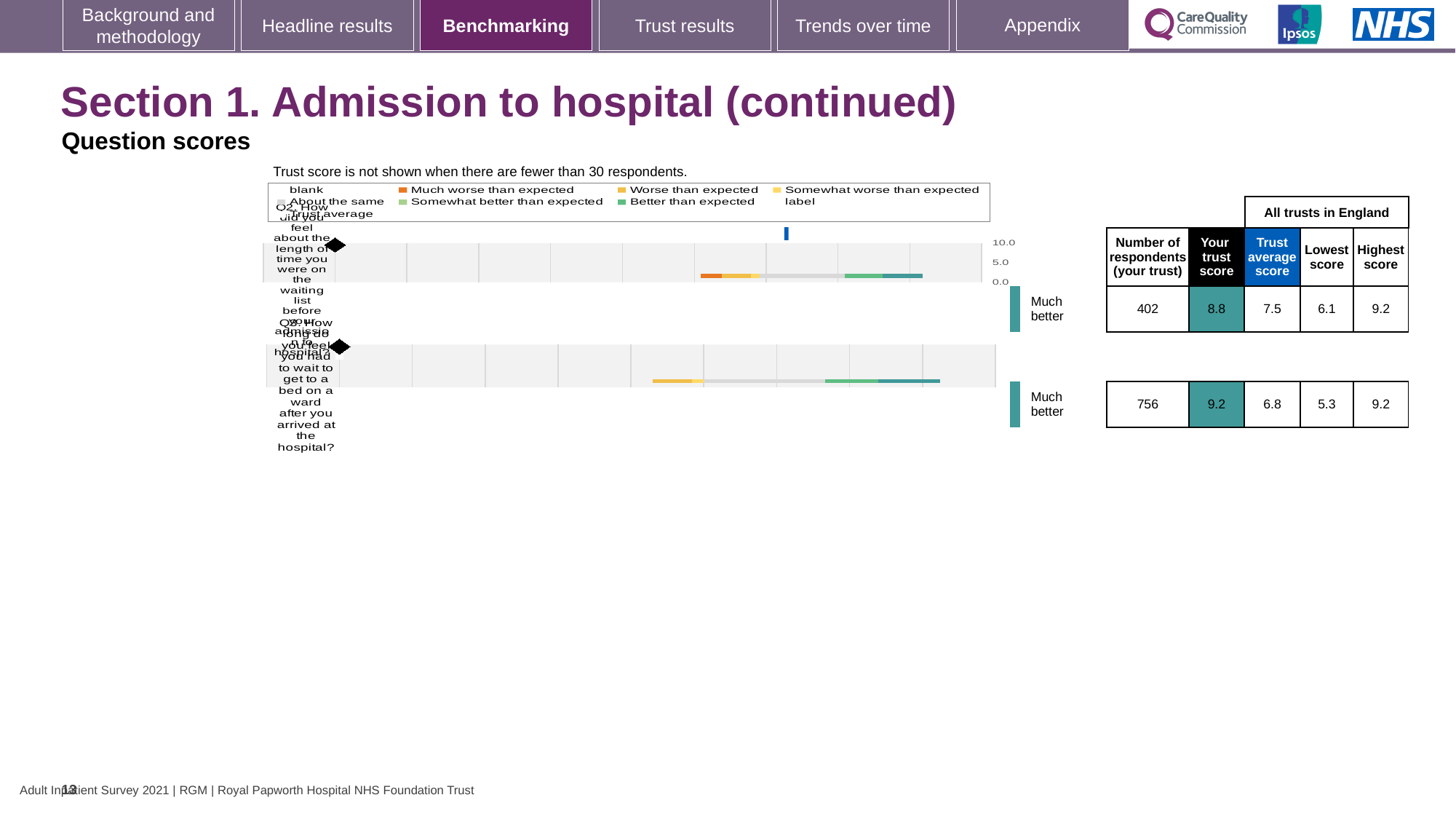
By how much does the trust's score for Q2 exceed the trust average score for Q2? 1.3 What is the highest score across all trusts in England for Q2? 9.2 What is the 'Your trust score' for Q3 (how long did you feel you had to wait to get to a bed on a ward after you arrived at the hospital)? 9.2 Is the trust score for Q2 greater or less than 5.0 on the chart's scale? greater What is the lowest score across all trusts in England for Q3? 5.3 Which question has the higher 'Your trust score', Q2 or Q3? Q3 What is the 'Your trust score' for Q2 (how did you feel about the length of time you were on the waiting list before your admission to hospital)? 8.8 By how much does the trust's score for Q3 exceed the trust average score for Q3? 2.4 How many questions are plotted on this slide? 2 How many respondents from the trust answered Q3? 756 What is the trust average score across all trusts in England for Q2? 7.5 What kind of chart is used to show the question scores on this slide? Bar chart